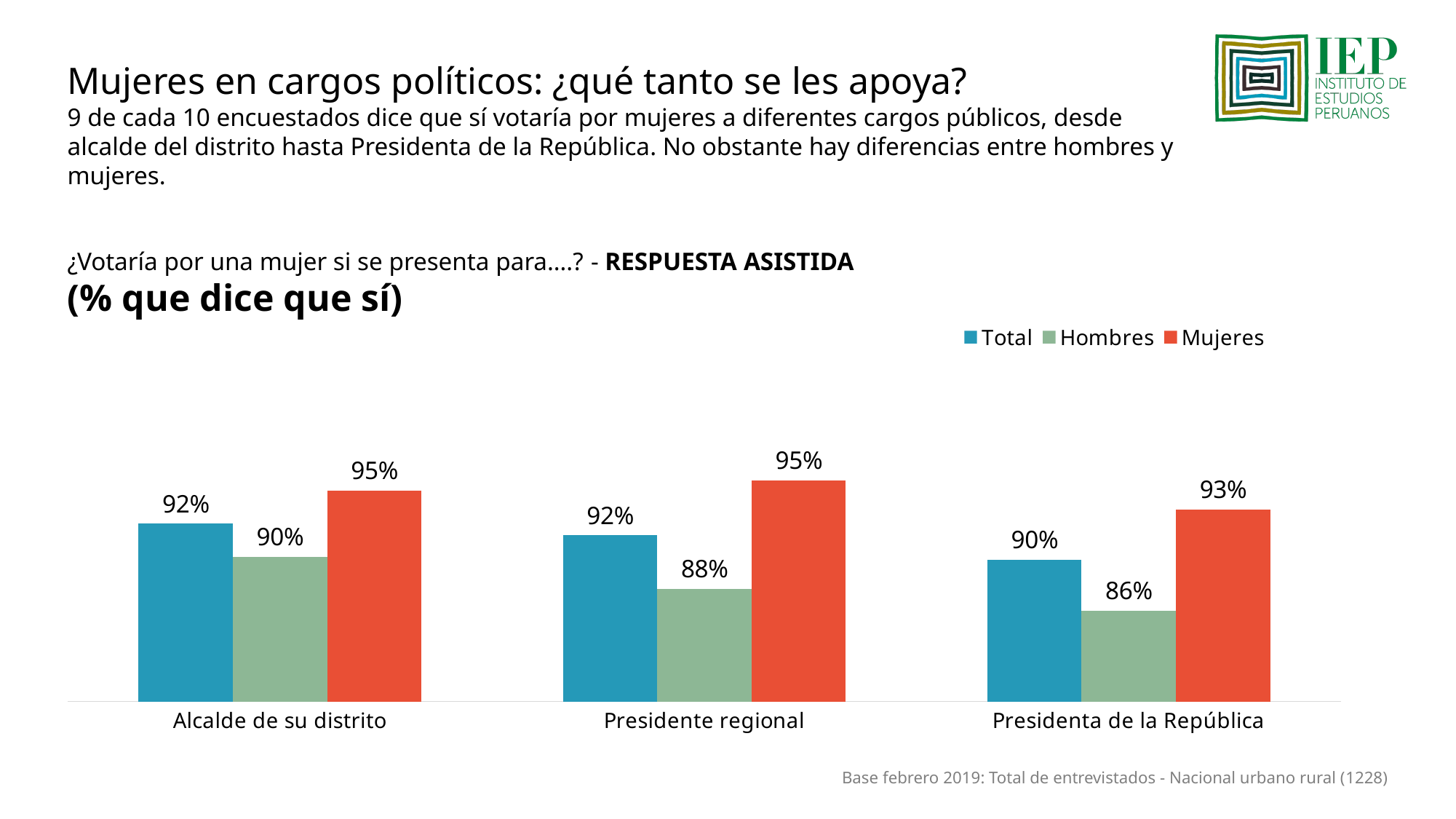
What is the Total value for Presidenta de la República? 90% Which is larger for Alcalde de su distrito: the Total value or the Hombres value? Total What is the difference between the Mujeres and Hombres values for Presidenta de la República? 7 percentage points How many categories are shown on the x axis? 3 Which category has the lowest value for Hombres? Presidenta de la República How many series does the legend list? 3 What is the value for Hombres for Presidente regional? 88% Which colour represents the Mujeres series in the legend? Red What is the difference between the Mujeres and Hombres values for Presidente regional? 7 percentage points What is the value for Mujeres for Alcalde de su distrito? 95% What kind of chart is shown on the slide? Bar chart Which category has the lowest value for Mujeres? Presidenta de la República